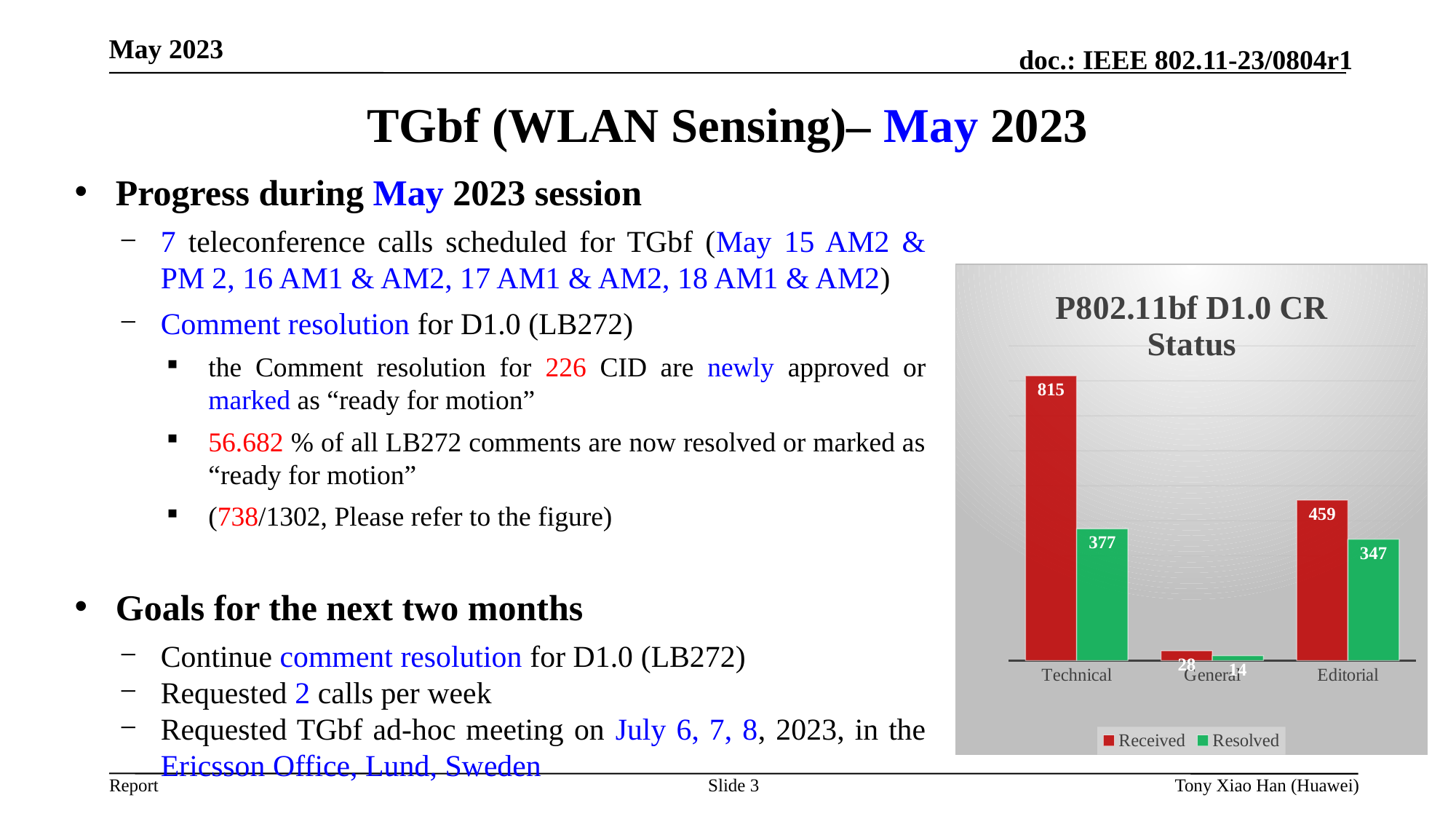
Which category has the highest Received value in the P802.11bf D1.0 CR Status chart? Technical How many categories are shown on the x axis of the P802.11bf D1.0 CR Status chart? 3 What kind of chart is the P802.11bf D1.0 CR Status chart? bar chart Is the Resolved value for Technical larger or smaller than the Received value for Editorial in the P802.11bf D1.0 CR Status chart? smaller What colour are the Resolved bars in the P802.11bf D1.0 CR Status chart? green What is the Received value for General in the P802.11bf D1.0 CR Status chart? 28 What is the Received value for Technical in the P802.11bf D1.0 CR Status chart? 815 Which category has the lowest Resolved value in the P802.11bf D1.0 CR Status chart? General How many series does the legend of the P802.11bf D1.0 CR Status chart list? 2 What is the difference between Received and Resolved for Technical in the P802.11bf D1.0 CR Status chart? 438 What is the difference between Received and Resolved for Editorial in the P802.11bf D1.0 CR Status chart? 112 What is the Resolved value for Editorial in the P802.11bf D1.0 CR Status chart? 347